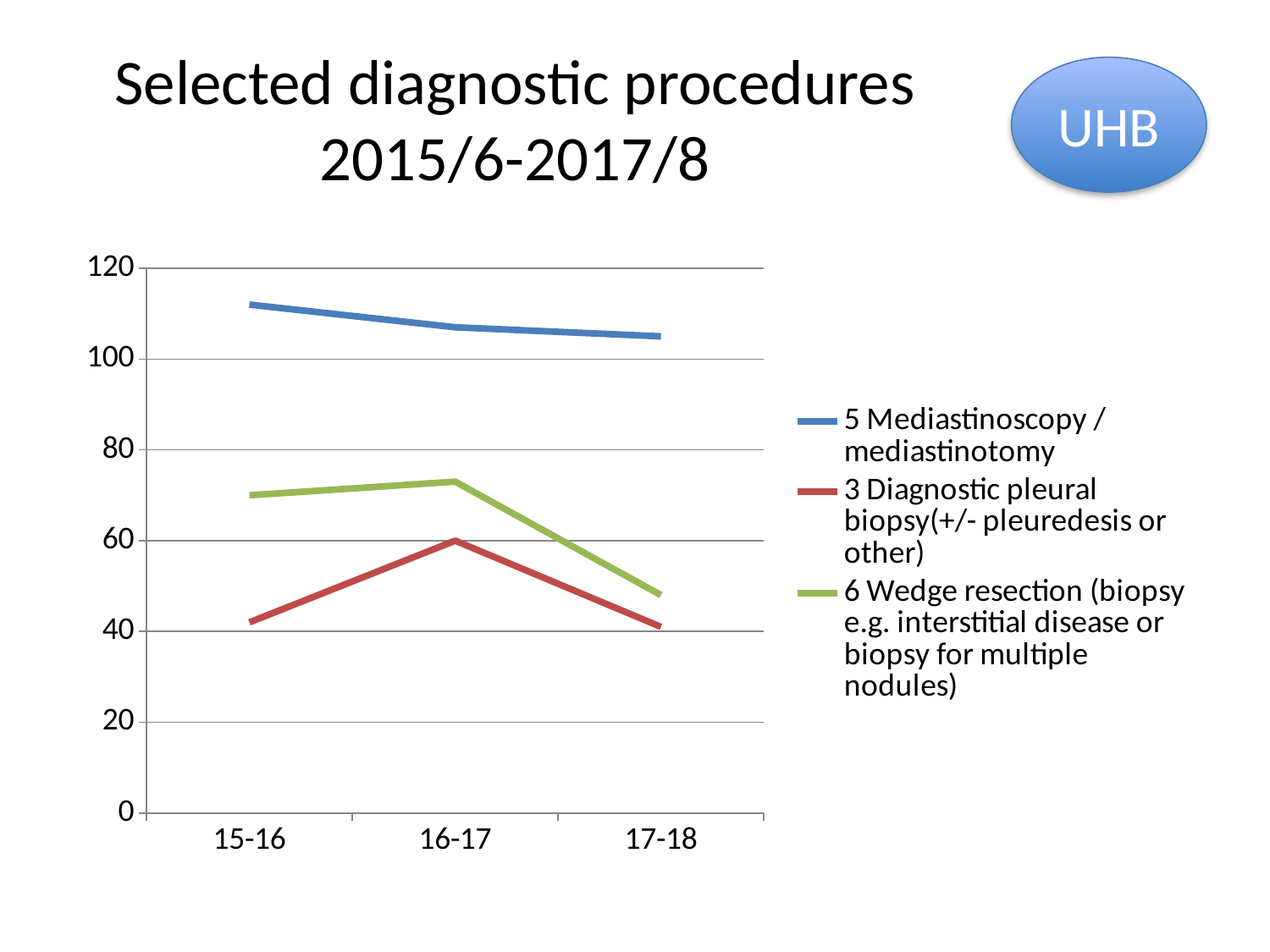
How many time periods are shown on the x axis? 3 In 16-17, which is larger: the value for 6 Wedge resection or the value for 3 Diagnostic pleural biopsy? 6 Wedge resection Is the value for 6 Wedge resection in 16-17 greater or less than 80? less In which period is the value for 3 Diagnostic pleural biopsy highest? 16-17 In which period is the value for 6 Wedge resection lowest? 17-18 Does the value for 5 Mediastinoscopy / mediastinotomy rise or fall from 15-16 to 17-18? fall What kind of chart is shown on the slide? line chart Which series has the highest value in 15-16? 5 Mediastinoscopy / mediastinotomy Is the value for 5 Mediastinoscopy / mediastinotomy in 15-16 greater or less than 100? greater How many series does the legend list? 3 Which series has the lowest value in 17-18? 3 Diagnostic pleural biopsy(+/- pleuredesis or other) Is the value for 6 Wedge resection in 17-18 greater or less than 60? less